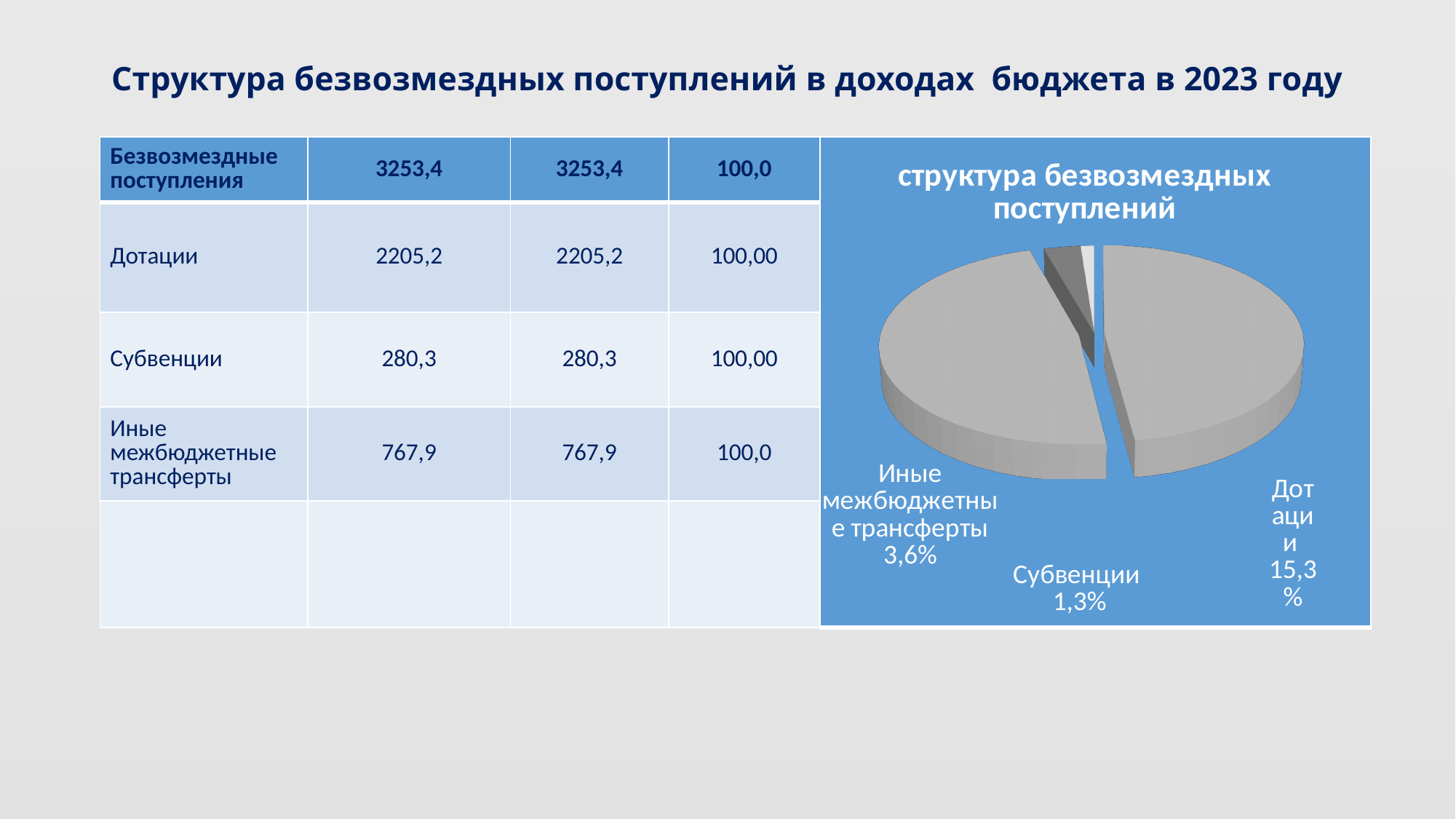
What is the difference between the percentage labels for Дотации and Иные межбюджетные трансферты in the pie chart? 11,7% What percentage is shown for Субвенции in the pie chart? 1,3% What percentage is shown for Дотации in the pie chart? 15,3% What kind of chart is shown on the slide? Pie chart Which category has the lowest percentage label in the pie chart? Субвенции Which category has the highest percentage label in the pie chart? Дотации What percentage is shown for Иные межбюджетные трансферты in the pie chart? 3,6% What is the difference between the percentage labels for Иные межбюджетные трансферты and Субвенции in the pie chart? 2,3% What is the title of the chart? структура безвозмездных поступлений Which has a larger percentage label in the pie chart, Субвенции or Иные межбюджетные трансферты? Иные межбюджетные трансферты How many categories are labelled in the pie chart? 3